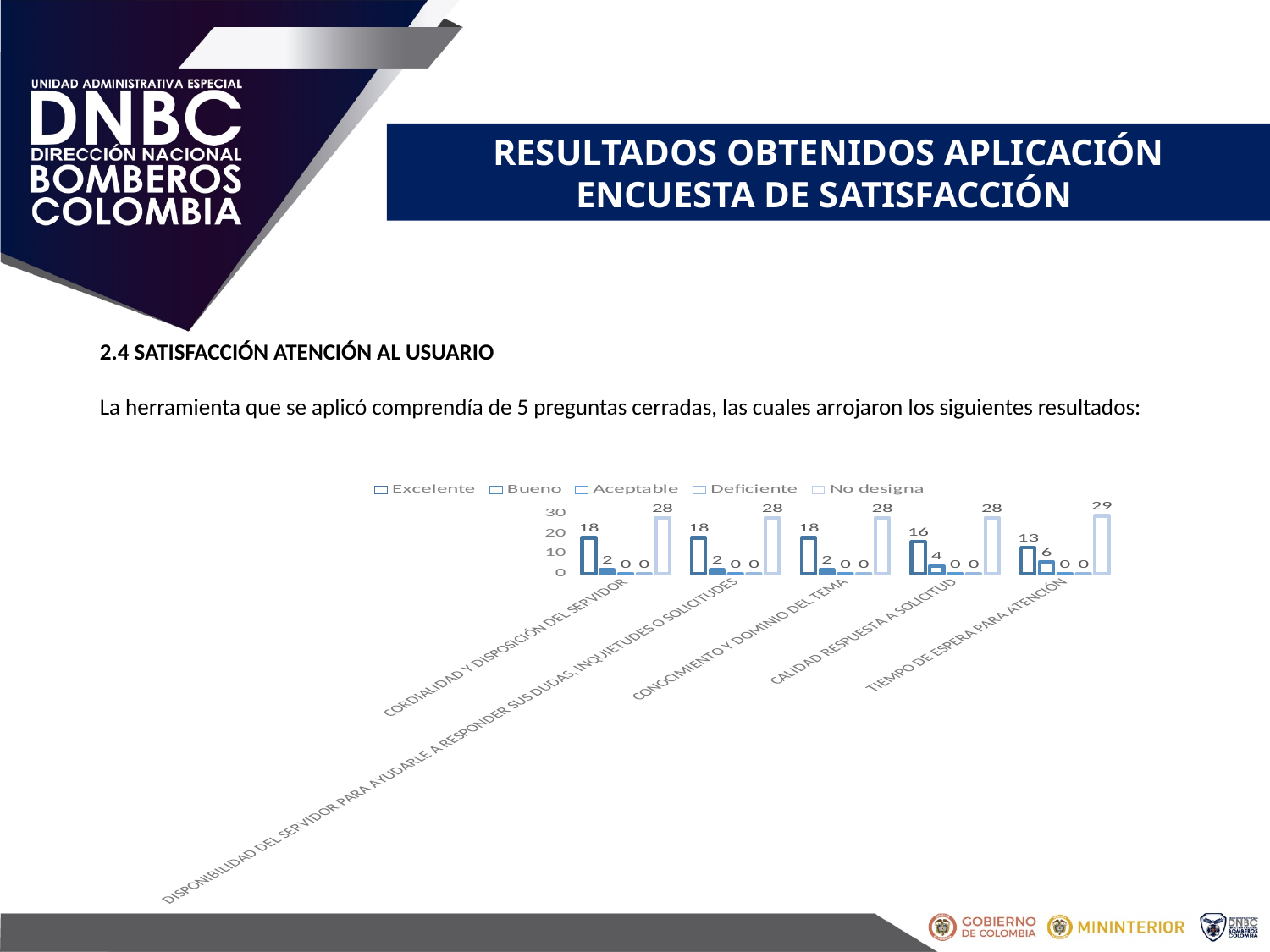
What is the Bueno value for CALIDAD RESPUESTA A SOLICITUD? 4 Which category has the lowest Excelente value? TIEMPO DE ESPERA PARA ATENCIÓN What is the Excelente value for TIEMPO DE ESPERA PARA ATENCIÓN? 13 What kind of chart is shown on the slide? bar chart What is the difference between the Excelente values for CORDIALIDAD Y DISPOSICIÓN DEL SERVIDOR and TIEMPO DE ESPERA PARA ATENCIÓN? 5 Which is larger for CALIDAD RESPUESTA A SOLICITUD: the Excelente value or the No designa value? No designa What is the Deficiente value for CONOCIMIENTO Y DOMINIO DEL TEMA? 0 Which category has the highest Bueno value? TIEMPO DE ESPERA PARA ATENCIÓN How many series does the legend list? 5 How many categories are plotted on the x axis? 5 What is the Excelente value for CONOCIMIENTO Y DOMINIO DEL TEMA? 18 What is the No designa value for TIEMPO DE ESPERA PARA ATENCIÓN? 29